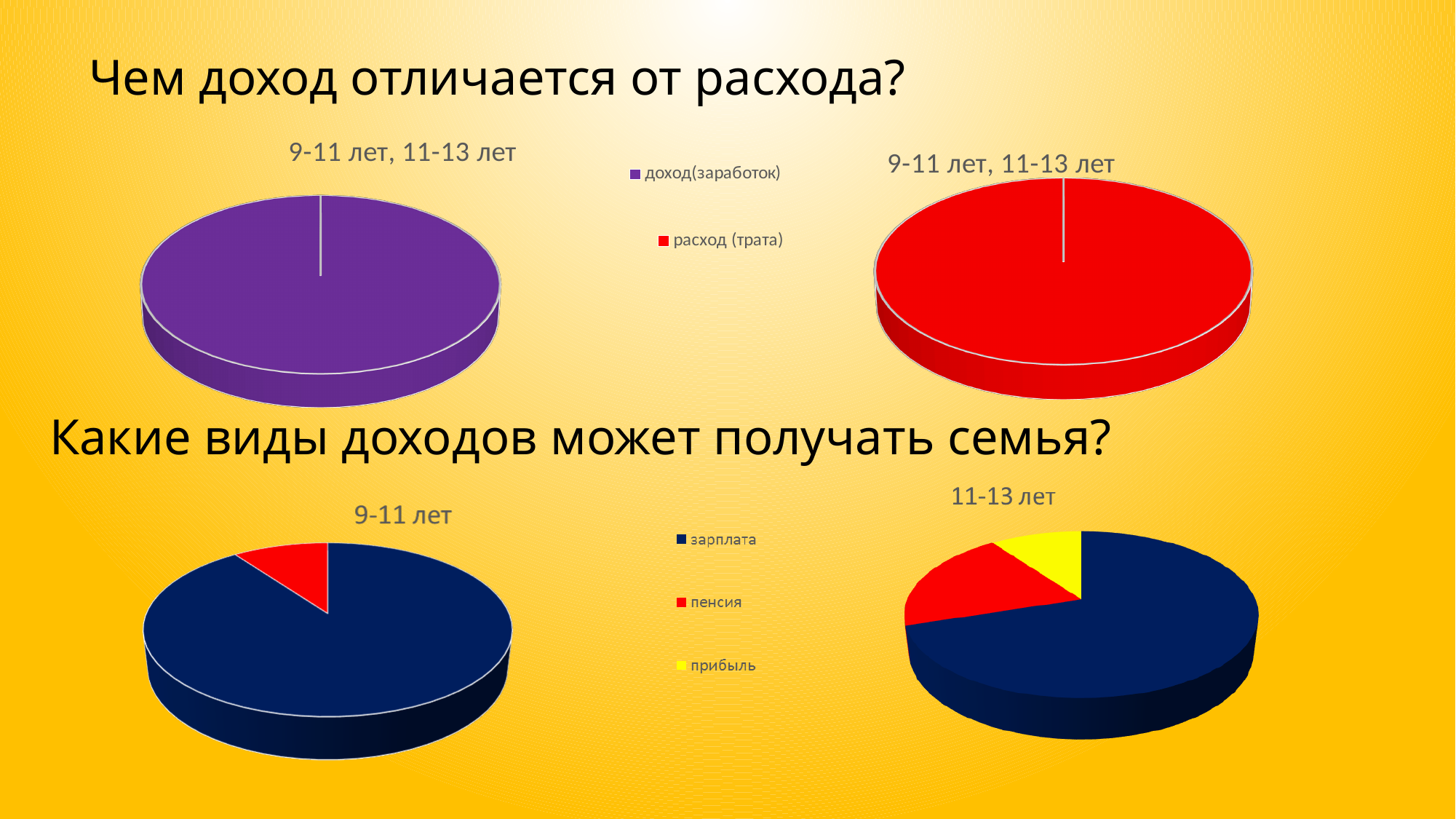
How many entries does the legend between the two top charts list? 2 In the bottom-left pie chart titled "9-11 лет", which category has the largest slice? зарплата In the top-right pie chart, which legend category does the red slice represent? расход (трата) How many slices does the top-right pie chart titled "9-11 лет, 11-13 лет" contain? 1 In the bottom-left pie chart titled "9-11 лет", which category has the smallest slice? пенсия How many slices does the bottom-left pie chart titled "9-11 лет" contain? 2 What kind of chart is the bottom-left chart titled "9-11 лет"? pie chart In the top-left pie chart, which legend category does the purple slice represent? доход(заработок) How many entries does the legend between the two bottom charts list? 3 In the bottom-right pie chart titled "11-13 лет", which slice is larger: пенсия or прибыль? пенсия What kind of chart is the top-left chart titled "9-11 лет, 11-13 лет"? pie chart In the bottom-right pie chart titled "11-13 лет", which category has the largest slice? зарплата